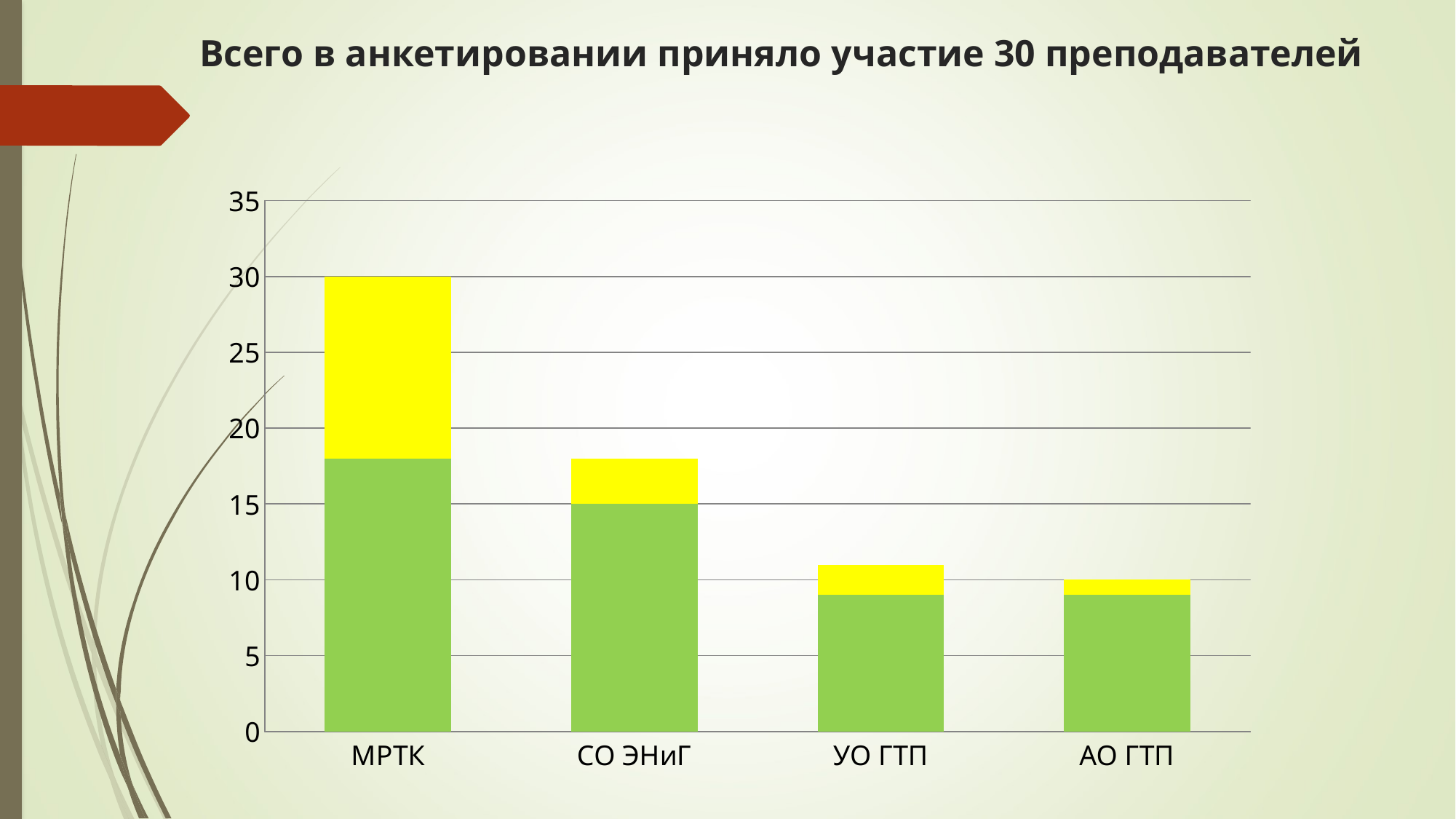
Which category has the highest total bar? МРТК Do the total bar heights rise or fall from left to right along the x axis? fall Is the total value for СО ЭНиГ greater or less than 20? less What is the total height of the stacked bar for АО ГТП? 10 What is the total height of the stacked bar for МРТК? 30 Is the total value for УО ГТП greater or less than 10? greater What kind of chart is shown on the slide? bar chart What is the title of the slide? Всего в анкетировании приняло участие 30 преподавателей How many categories are shown on the x axis? 4 Which category has the lowest total bar? АО ГТП Which has a larger total bar, МРТК or СО ЭНиГ? МРТК What is the value of the green segment for СО ЭНиГ? 15